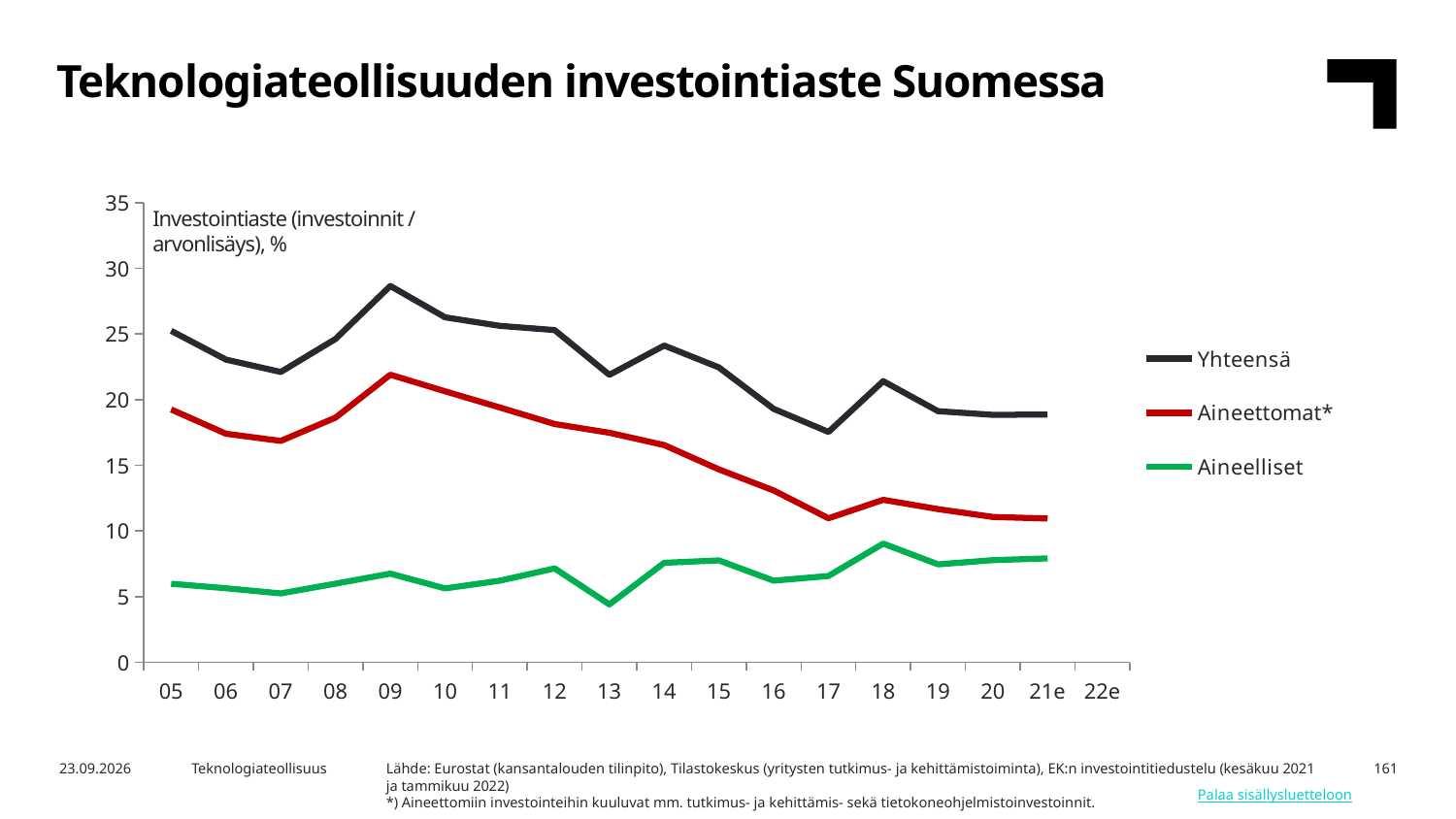
Is the value for Aineettomat* in 17 greater or less than 15? less Which series are listed in the legend? Yhteensä, Aineettomat*, Aineelliset In which year does the Yhteensä series reach its lowest value? 17 How many year labels are shown on the x axis? 18 Does the Aineettomat* series rise or fall from 09 to 17? fall Is the value for Yhteensä in 09 greater or less than 25? greater In which year does the Yhteensä series reach its highest value? 09 What kind of chart is shown on the slide? line chart In which year does the Aineelliset series reach its highest value? 18 How many series does the legend list? 3 Which is larger in 09, Aineettomat* or Aineelliset? Aineettomat* In which year does the Aineelliset series reach its lowest value? 13